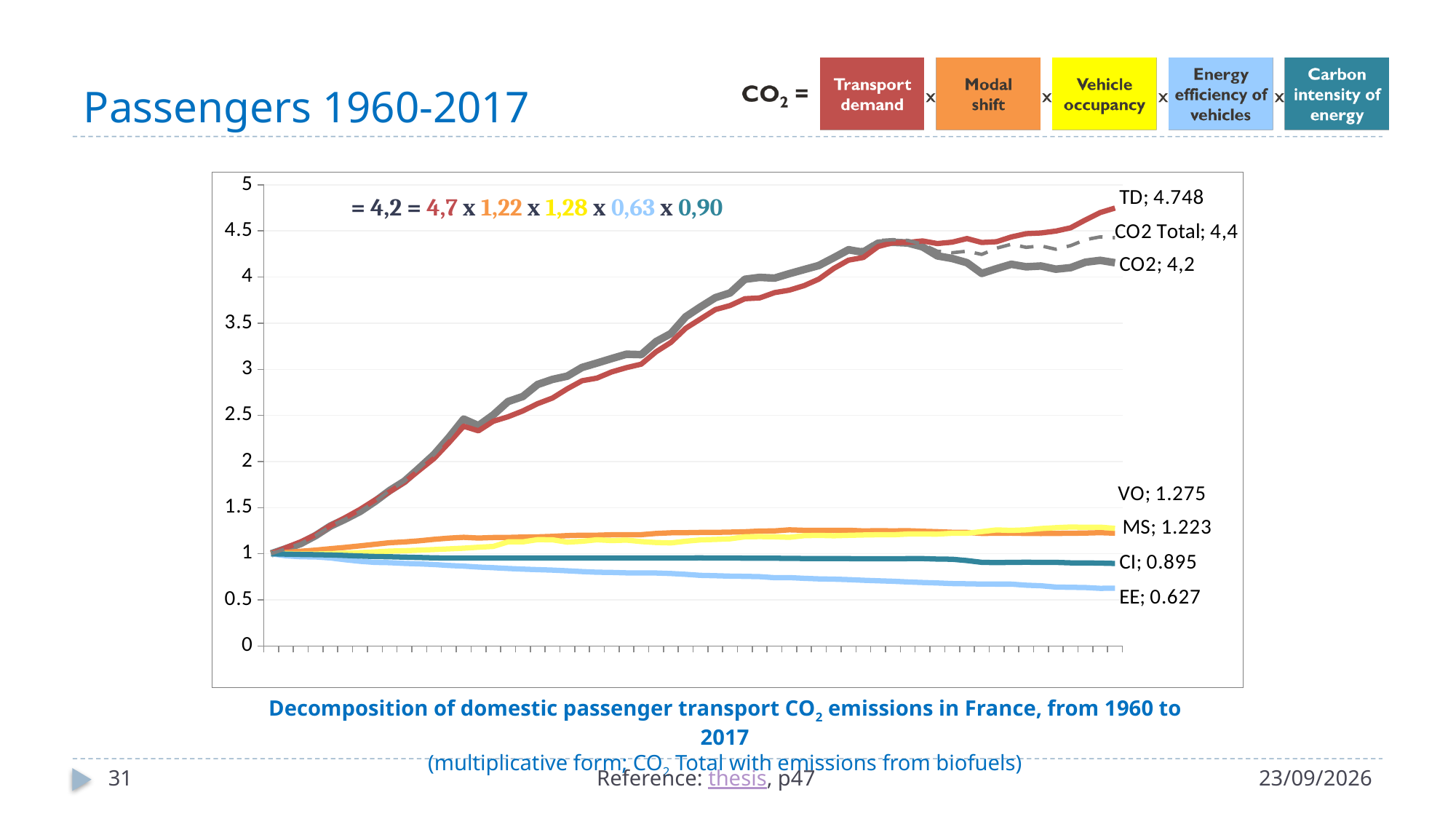
What is the final value shown for MS (modal shift) in the chart? 1.223 What is the final value labelled for CO2 Total in the chart? 4,4 Which has a larger final value, CI or EE? CI Which series has the lowest final value in the chart? EE Does the EE series rise or fall over the period shown? Fall What is the final value shown for EE (energy efficiency) in the chart? 0.627 What is the difference between the final values of VO and MS? 0.052 Which series has the highest final value in the chart? TD What is the final value shown for TD (transport demand) in the chart? 4.748 What is the final value shown for CI (carbon intensity) in the chart? 0.895 What is the final value shown for VO (vehicle occupancy) in the chart? 1.275 What kind of chart is shown on the slide? Line chart